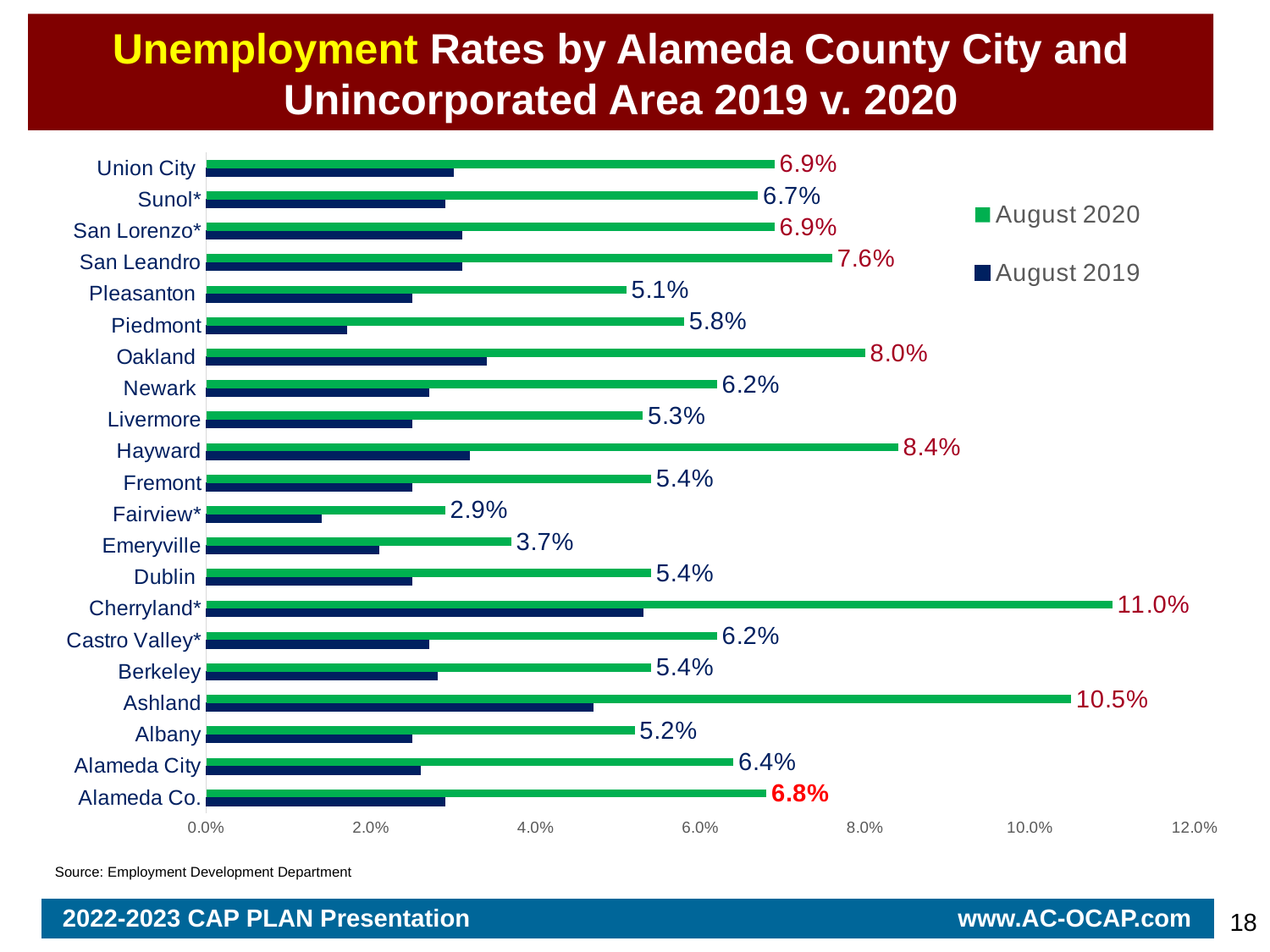
Which has a higher August 2020 unemployment rate, San Leandro or Newark? San Leandro Which area has the lowest August 2020 unemployment rate? Fairview* How many cities and areas are shown on the chart? 21 What is the August 2020 unemployment rate for Oakland? 8.0% What type of chart is shown on the slide? Bar chart What is the August 2020 unemployment rate for Alameda Co.? 6.8% What is the difference between the August 2020 unemployment rates of Ashland and Hayward? 2.1% What is the August 2020 unemployment rate for Cherryland*? 11.0% Which area has the highest August 2020 unemployment rate? Cherryland* How many series does the legend list? 2 Is the August 2019 unemployment rate for Piedmont greater or less than 2.0%? less Is the August 2019 unemployment rate for Cherryland* greater or less than 4.0%? greater